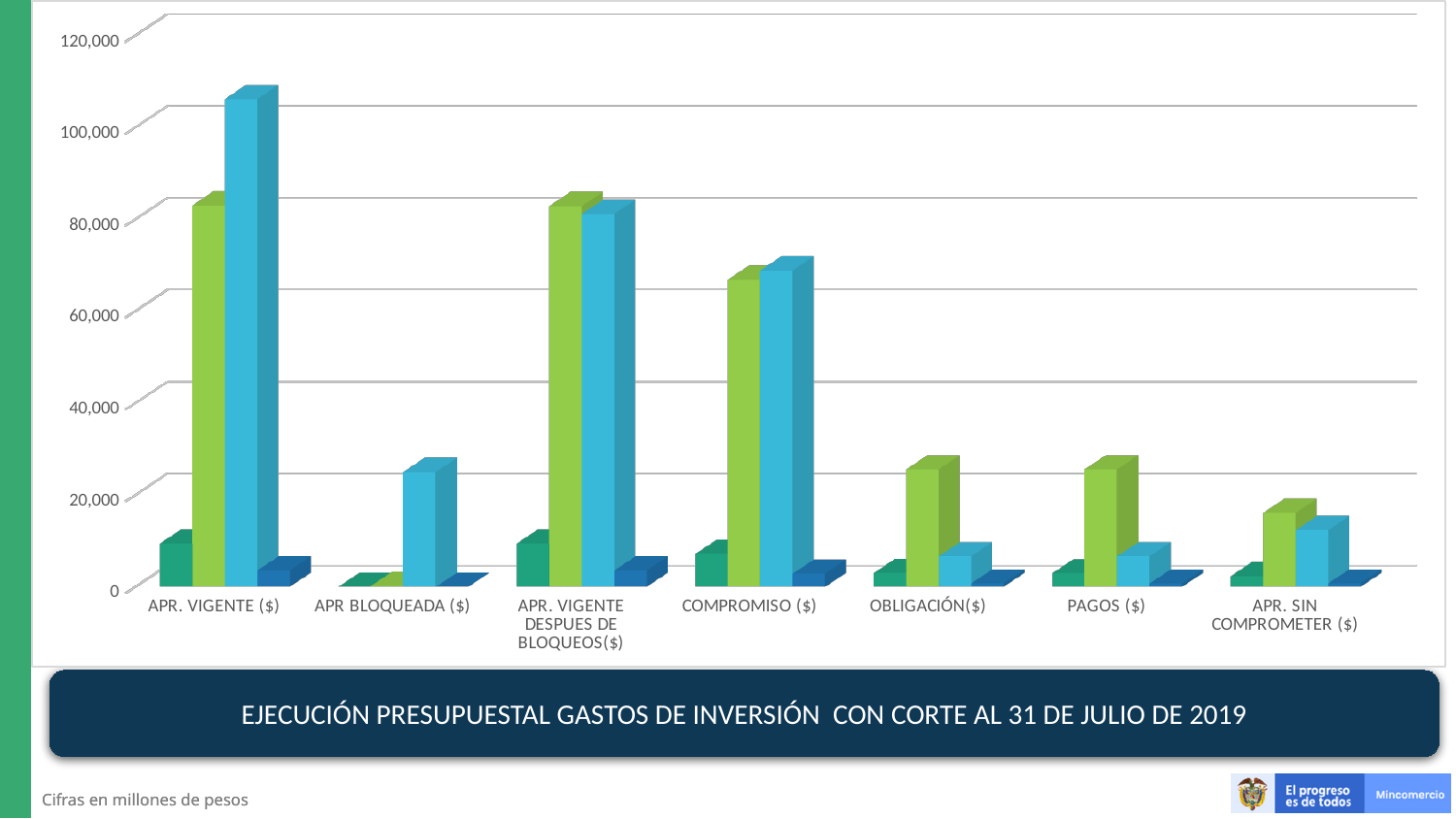
Is the light blue bar for APR. VIGENTE ($) greater or less than 100,000? greater What is the title shown beneath the chart? EJECUCIÓN PRESUPUESTAL GASTOS DE INVERSIÓN CON CORTE AL 31 DE JULIO DE 2019 Is the light blue bar for OBLIGACIÓN($) greater or less than 20,000? less Which is larger: the light green bar for COMPROMISO ($) or the light green bar for PAGOS ($)? COMPROMISO ($) Which category contains the tallest bar in the chart? APR. VIGENTE ($) How many bars are plotted for each category in the chart? 4 Is the light blue bar for COMPROMISO ($) greater or less than 60,000? greater How many categories are shown along the x axis of the chart? 7 What kind of chart is shown on the slide? bar chart Which is larger: the light blue bar for APR. VIGENTE ($) or the light blue bar for APR. VIGENTE DESPUES DE BLOQUEOS($)? APR. VIGENTE ($)